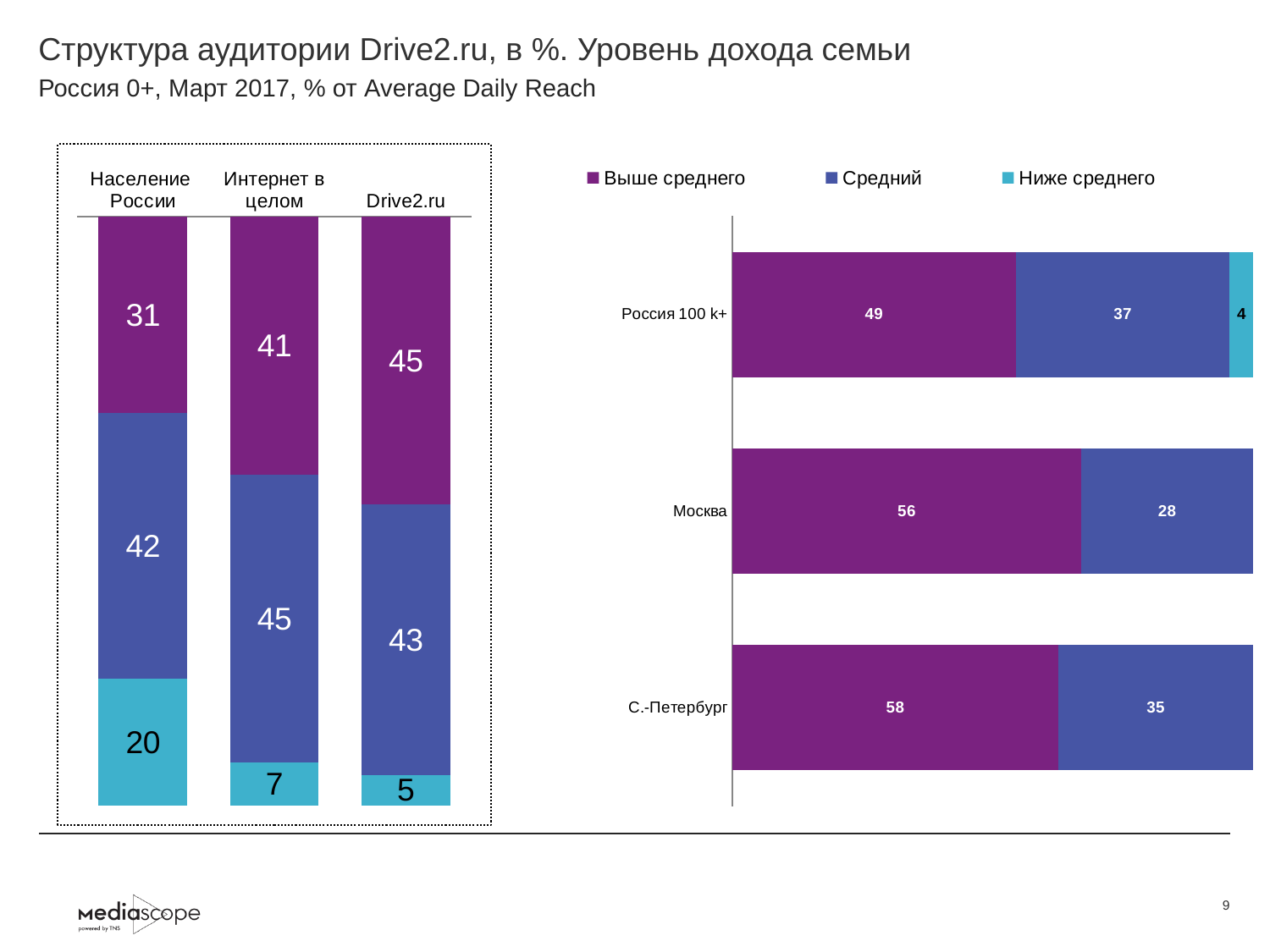
What type of chart is the right chart? Stacked bar chart In the right chart, which category has the highest 'Выше среднего' value? С.-Петербург In the left chart, what is the total of the stacked bar for 'Интернет в целом'? 93 In the left chart, what is the difference between the 'Выше среднего' values for 'Drive2.ru' and 'Население России'? 14 In the right chart, what is the value of the 'Ниже среднего' segment for 'Россия 100 k+'? 4 In the right chart, what is the value of the 'Выше среднего' segment for 'С.-Петербург'? 58 How many series does the legend of the right chart list? 3 In the right chart, which is larger: the 'Средний' value for 'Москва' or for 'С.-Петербург'? С.-Петербург In the left chart, what is the value of the 'Выше среднего' segment for 'Drive2.ru'? 45 In the left chart, what is the value of the 'Ниже среднего' segment for 'Население России'? 20 In the left chart, which category has the lowest 'Ниже среднего' value? Drive2.ru In the left chart, what is the value of the 'Средний' segment for 'Интернет в целом'? 45